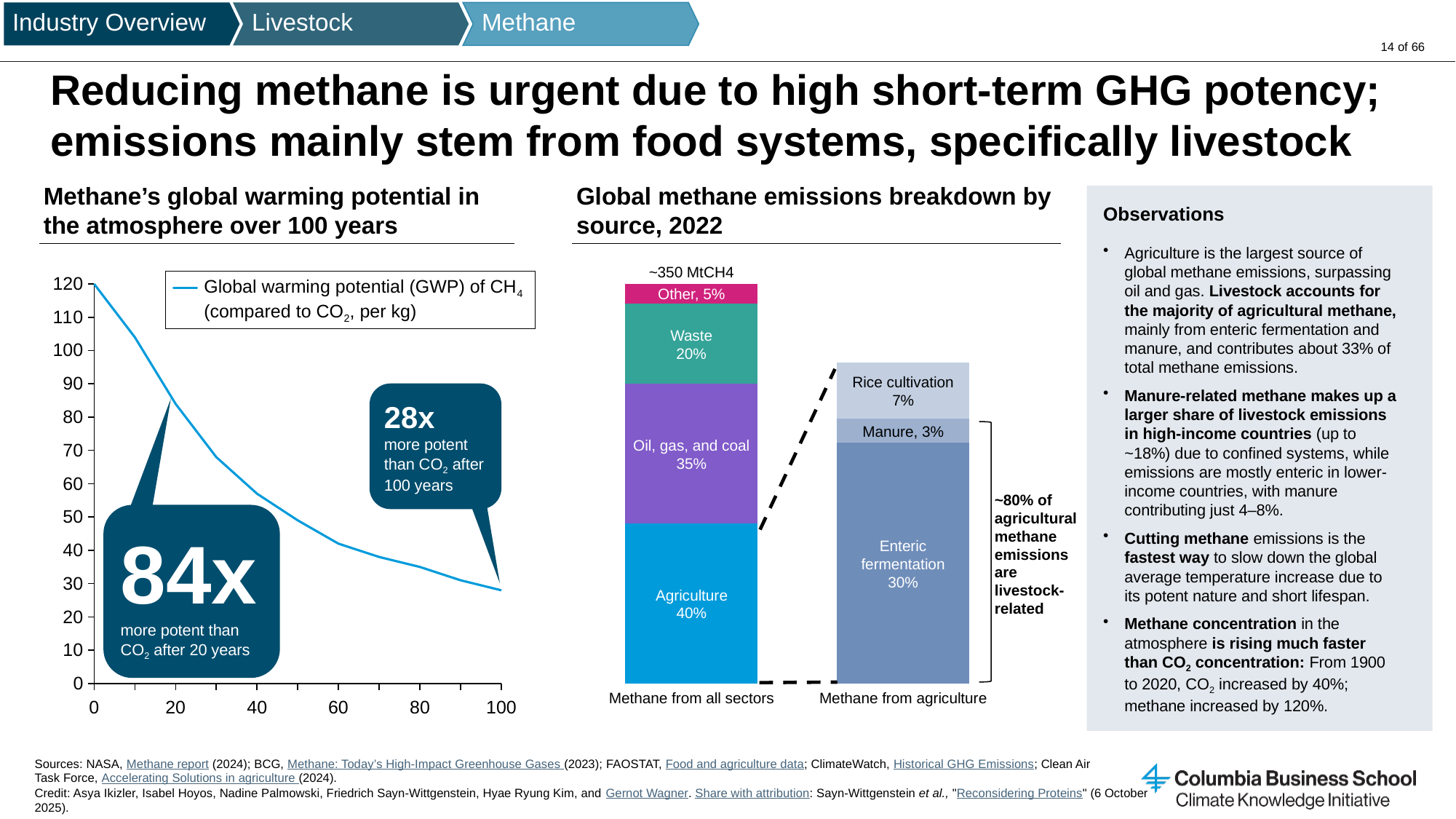
In the chart 'Methane's global warming potential in the atmosphere over 100 years', how many times more potent than CO2 is methane after 20 years? 84x In the chart 'Global methane emissions breakdown by source, 2022', what share of methane from all sectors comes from agriculture? 40% In the chart 'Global methane emissions breakdown by source, 2022', what share of methane from all sectors comes from oil, gas, and coal? 35% In the chart 'Global methane emissions breakdown by source, 2022', which is larger: the share for Rice cultivation or the share for Manure? Rice cultivation In the chart 'Global methane emissions breakdown by source, 2022', what is the difference between the Waste share and the Other share in the 'Methane from all sectors' bar? 15% In the chart 'Methane's global warming potential in the atmosphere over 100 years', does the global warming potential of CH4 rise or fall as the years increase? Fall In the chart 'Global methane emissions breakdown by source, 2022', what share does enteric fermentation contribute? 30% In the chart 'Global methane emissions breakdown by source, 2022', what is the total of the 'Methane from agriculture' stacked bar? 40% What kind of chart is 'Methane's global warming potential in the atmosphere over 100 years'? Line chart In the chart 'Global methane emissions breakdown by source, 2022', which segment of the 'Methane from all sectors' bar is the smallest? Other In the chart 'Global methane emissions breakdown by source, 2022', which segment of the 'Methane from all sectors' bar is the largest? Agriculture In the chart 'Global methane emissions breakdown by source, 2022', how many segments make up the 'Methane from agriculture' bar? 3